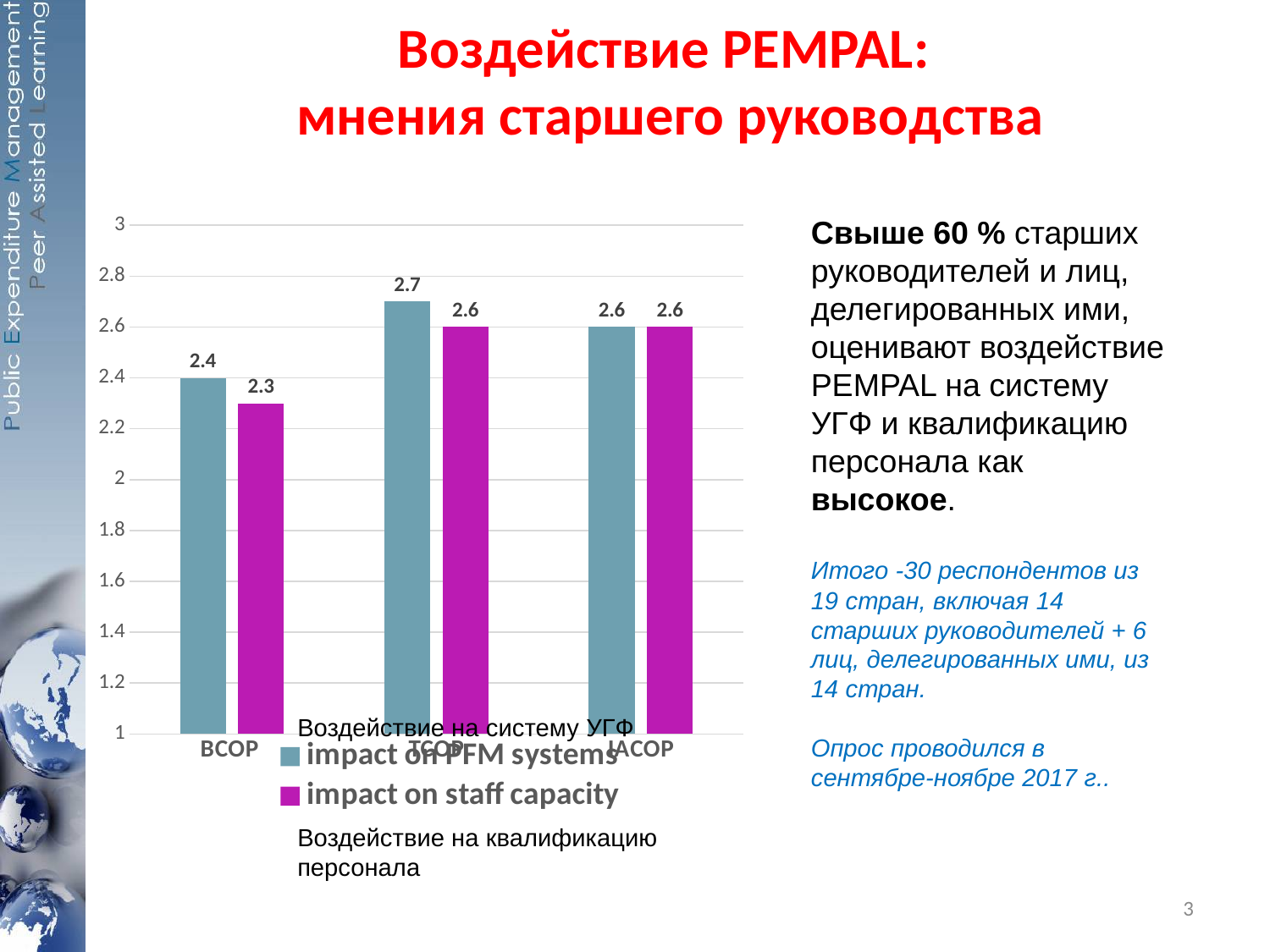
What kind of chart is shown on the slide? bar chart What is the value of 'impact on PFM systems' for BCOP? 2.4 Which category has the highest value for 'impact on PFM systems'? TCOP What is the difference between 'impact on PFM systems' for TCOP and for BCOP? 0.3 How many series does the chart legend list? 2 What is the value of 'impact on staff capacity' for IACOP? 2.6 Which colour represents 'impact on staff capacity' in the chart? magenta Which category has the lowest value for 'impact on staff capacity'? BCOP How many categories are shown on the x axis of the chart? 3 What is the value of 'impact on staff capacity' for BCOP? 2.3 What is the value of 'impact on PFM systems' for TCOP? 2.7 Which is larger for BCOP: 'impact on PFM systems' or 'impact on staff capacity'? impact on PFM systems